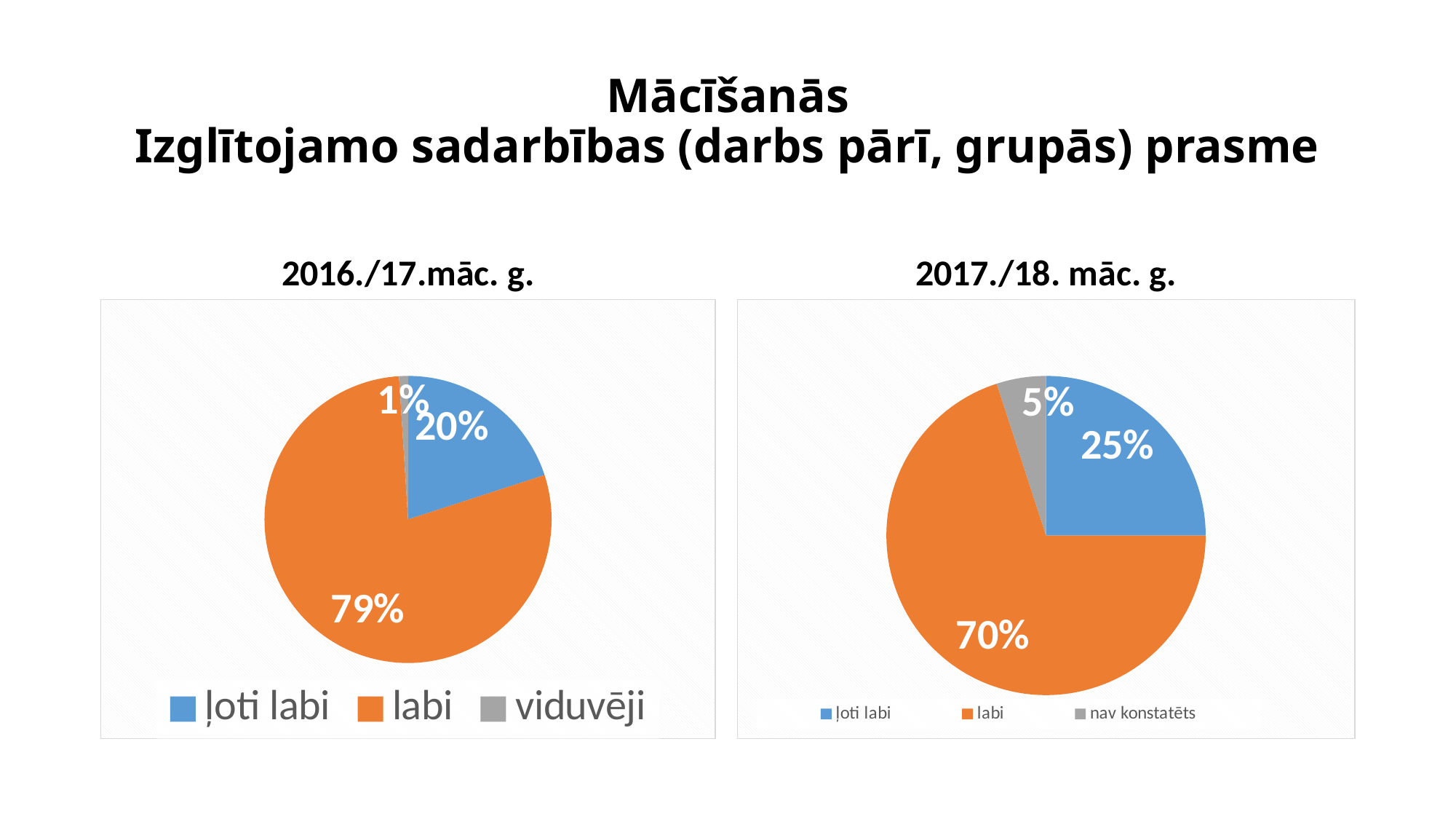
In the 2017./18. māc. g. chart, what share does 'nav konstatēts' have? 5% In the 2017./18. māc. g. chart, which category has the smallest slice? nav konstatēts How many slices does the 2016./17.māc. g. chart have? 3 In the 2016./17.māc. g. chart, what share does 'labi' have? 79% What type of chart is the 2017./18. māc. g. chart? pie chart In the 2016./17.māc. g. chart, what colour is the 'labi' slice? orange In the 2017./18. māc. g. chart, what share does 'ļoti labi' have? 25% How many entries does the legend of the 2017./18. māc. g. chart list? 3 In the 2017./18. māc. g. chart, what is the difference between the 'labi' and 'ļoti labi' shares? 45% In the 2016./17.māc. g. chart, which category has the largest slice? labi Which is larger: 'ļoti labi' in the 2016./17.māc. g. chart or 'ļoti labi' in the 2017./18. māc. g. chart? 2017./18. māc. g. In the 2016./17.māc. g. chart, what share does 'viduvēji' have? 1%